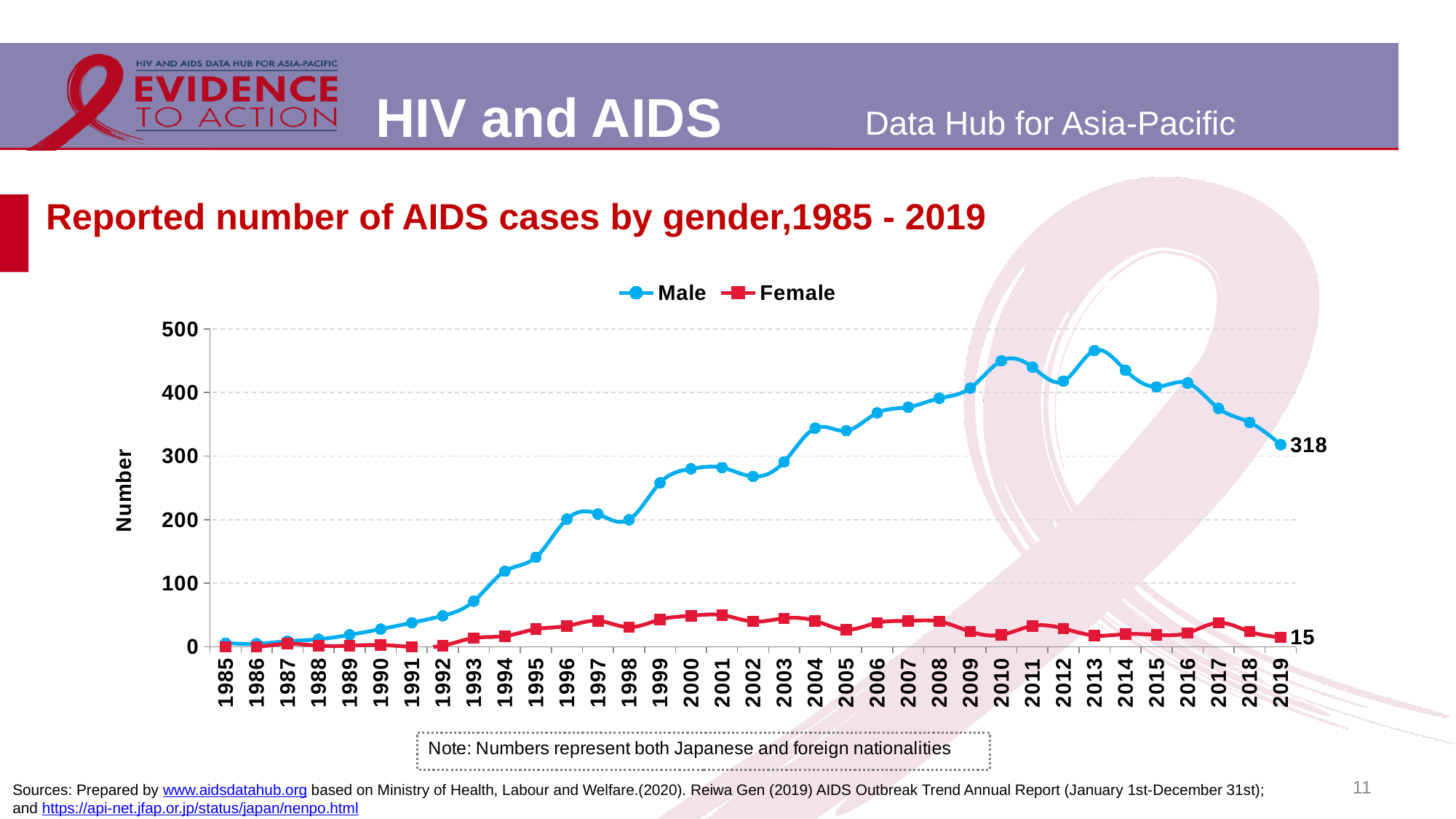
What is the difference between the Male and Female values in 2019? 303 Is the Male value for 1985 greater or less than 100? less What is the number of reported AIDS cases for Female in 2019? 15 Is the Male value for 2013 greater or less than 400? greater How many series does the legend list? 2 In which year does the Male series reach its highest value? 2013 Does the Male series rise or fall between 2013 and 2019? Fall In 2019, which series has the larger value, Male or Female? Male What kind of chart is shown on the slide? Line chart What is the number of reported AIDS cases for Male in 2019? 318 Is the Female value for 2001 greater or less than 100? less How many years are shown on the x axis? 35